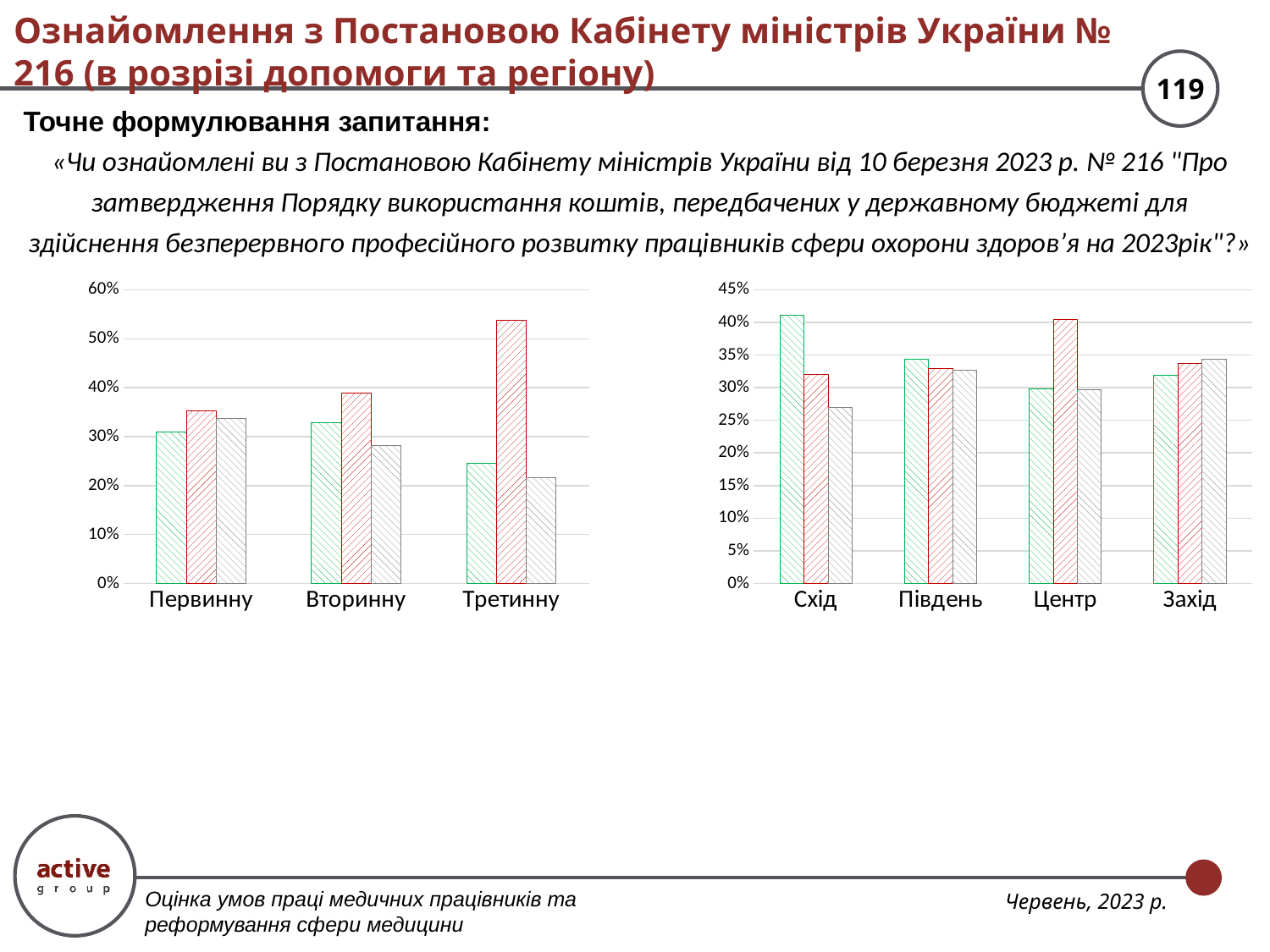
How many categories are shown on the x axis of the left chart? 3 What kind of chart is the left chart? bar chart How many categories are shown on the x axis of the right chart? 4 In the left chart, which category has the tallest red bar? Третинну In the right chart, which category has the tallest red bar? Центр In the right chart, is the grey bar for Схід greater or less than 30%? less In the right chart, is the green bar for Схід greater or less than 35%? greater What is the highest value shown on the y axis of the right chart? 45% In the right chart, which category has the tallest green bar? Схід In the left chart, is the red bar for Третинну greater or less than 50%? greater In the left chart, which category has the lowest grey bar? Третинну